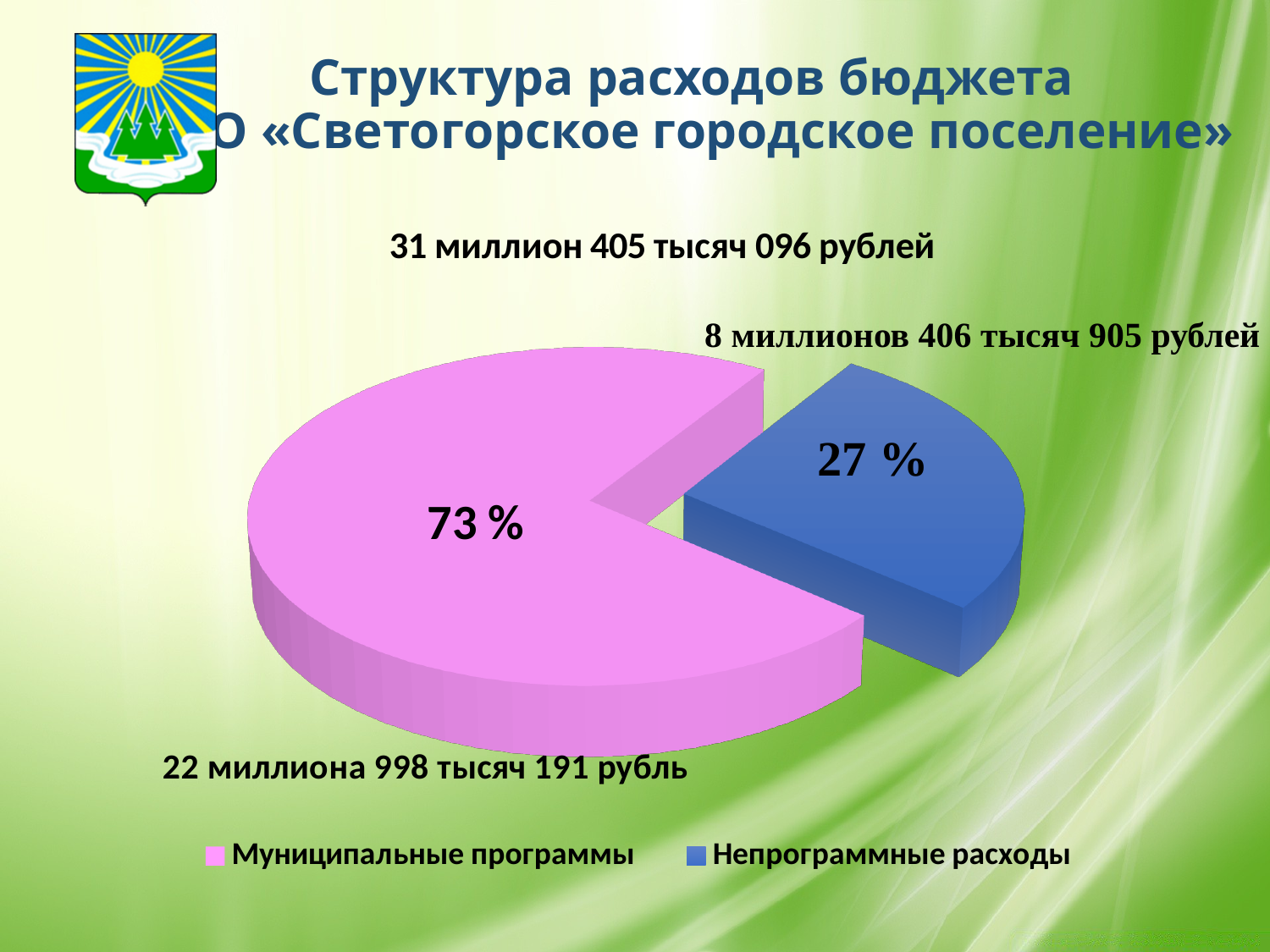
What share of the pie does Муниципальные программы take? 73 % What kind of chart is shown on the slide? pie chart Which slice of the pie is the largest? Муниципальные программы How many slices does the pie chart have? 2 Which is larger: the share for Муниципальные программы or the share for Непрограммные расходы? Муниципальные программы What colour is the Непрограммные расходы slice in the pie chart? blue What amount in rubles is labelled for the Муниципальные программы slice? 22 миллиона 998 тысяч 191 рубль What share of the pie does Непрограммные расходы take? 27 % By how many percentage points does the Муниципальные программы share exceed the Непрограммные расходы share? 46 Which slice of the pie is the smallest? Непрограммные расходы How many entries does the legend list? 2 What amount in rubles is labelled for the Непрограммные расходы slice? 8 миллионов 406 тысяч 905 рублей